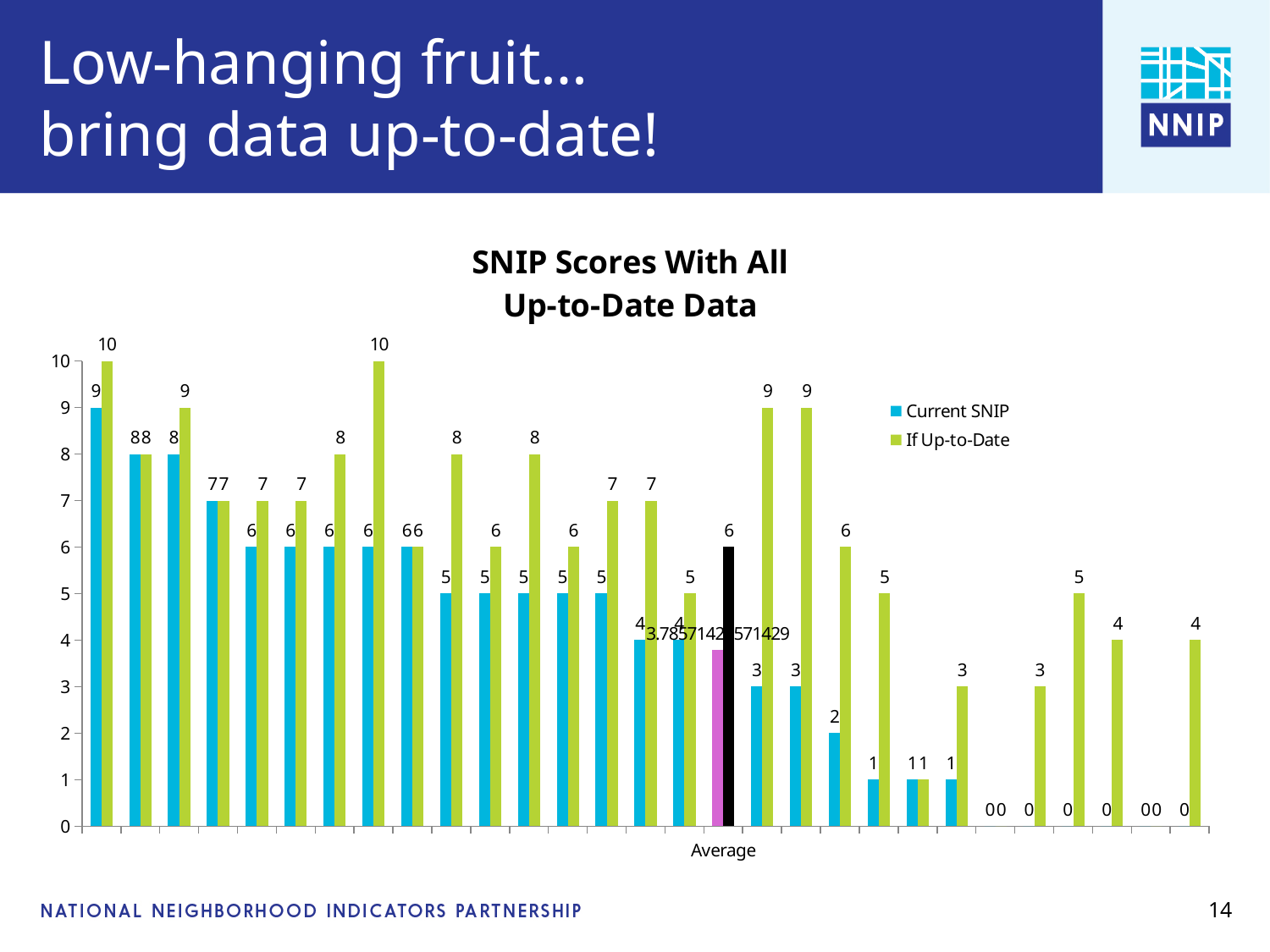
What are the two series named in the legend? Current SNIP and If Up-to-Date What is the title of the chart? SNIP Scores With All Up-to-Date Data Is the Current SNIP value for Average greater or less than 4? less What is the If Up-to-Date value for the Average category? 6 How many series does the legend list? 2 What is the highest value labeled on any bar in the chart? 10 Is the Current SNIP value for Average greater or less than 3? greater What kind of chart is shown on the slide? bar chart For the Average category, which series has the larger value, Current SNIP or If Up-to-Date? If Up-to-Date What is the lowest value labeled on any bar in the chart? 0